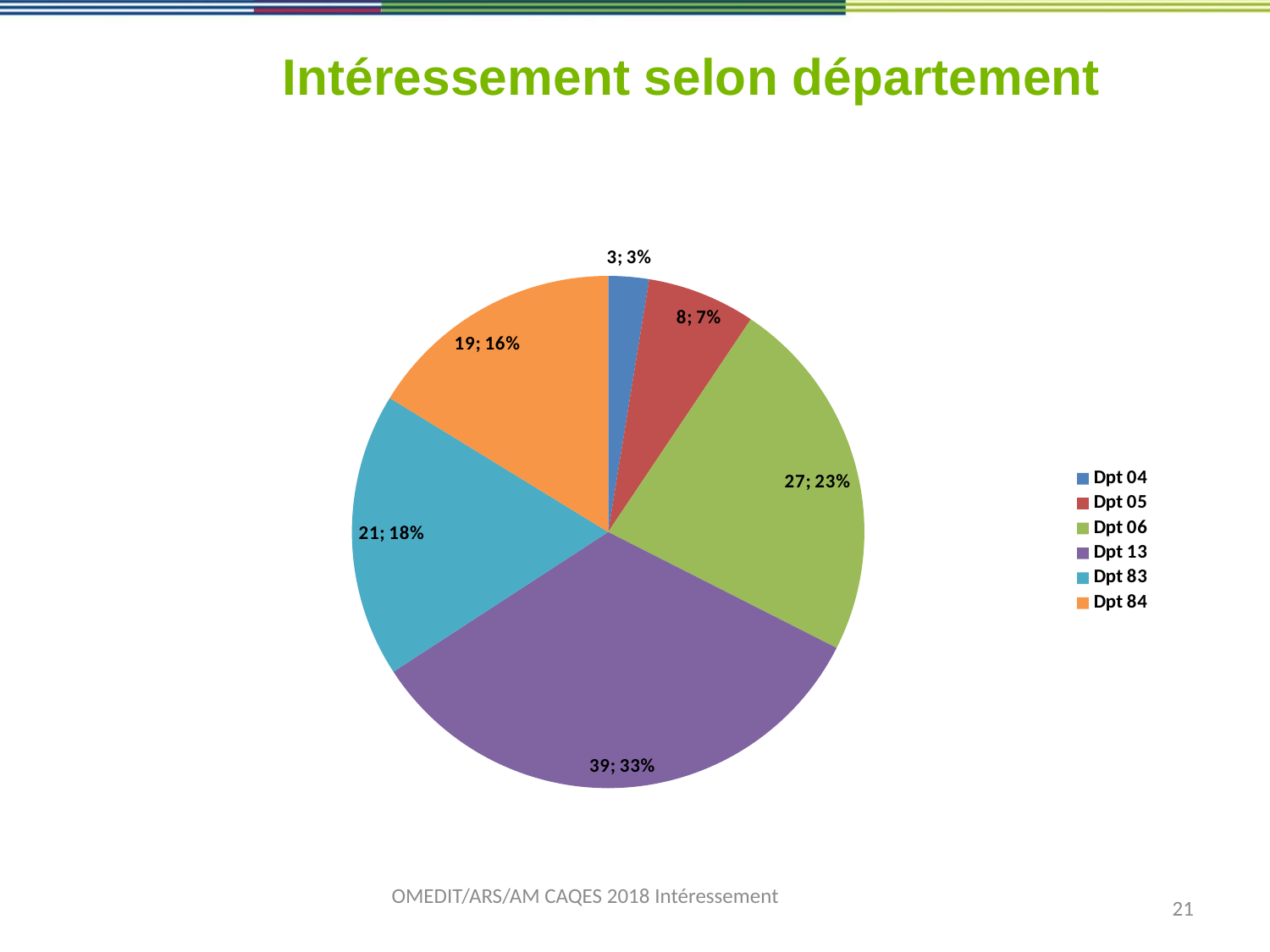
What is the value for Dpt 84? 19 Which is larger, the value for Dpt 83 or the value for Dpt 84? Dpt 83 What share of the pie does Dpt 83 represent? 18% What kind of chart is shown on the slide? pie chart What is the difference between the values for Dpt 13 and Dpt 06? 12 What is the value for Dpt 13? 39 How many departments are shown in the pie chart? 6 What is the value for Dpt 06? 27 Which department has the largest slice? Dpt 13 What share of the pie does Dpt 05 represent? 7% What is the title of the chart? Intéressement selon département Which department has the smallest slice? Dpt 04